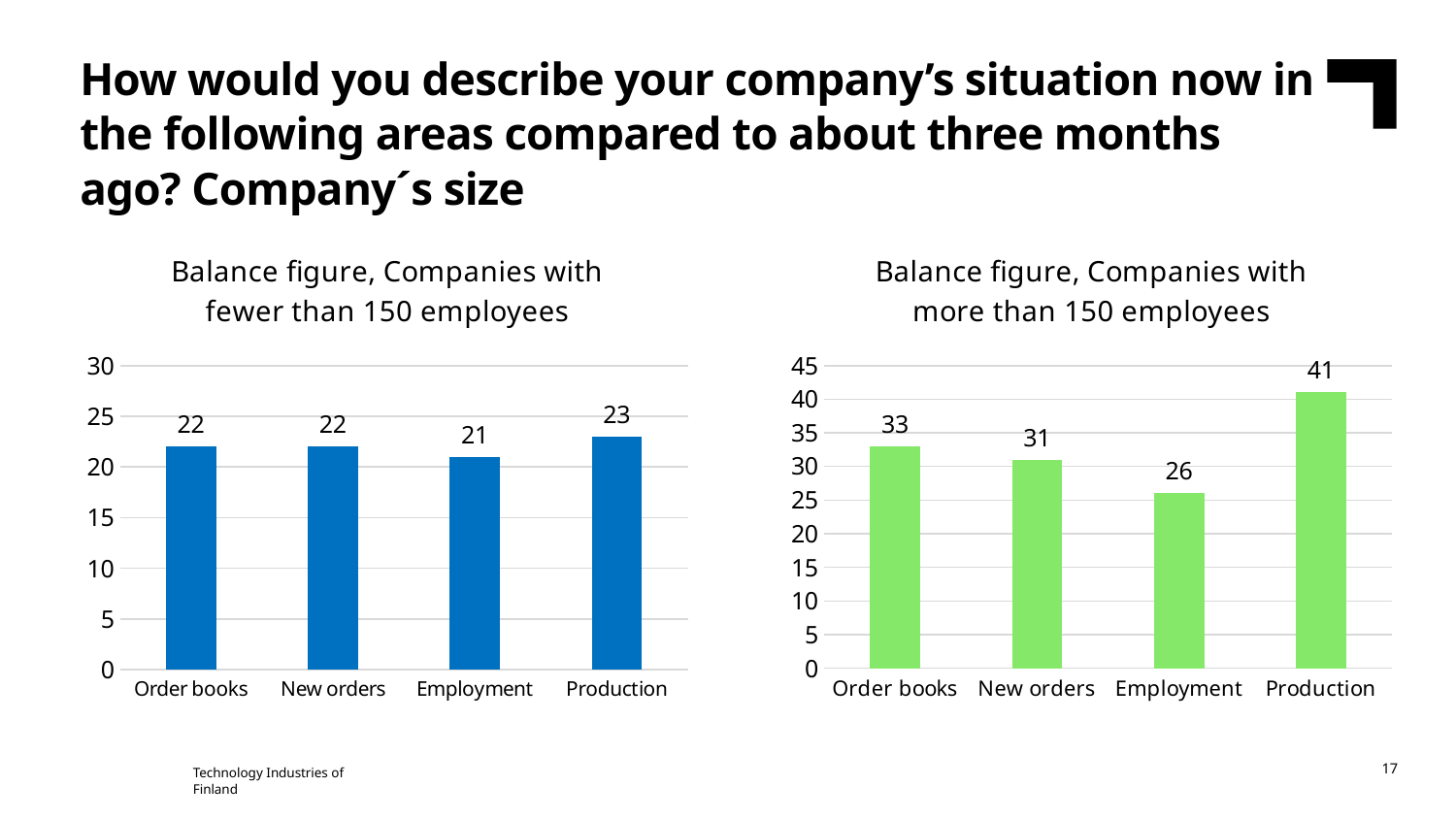
Which is larger: the value for New orders in the chart for companies with fewer than 150 employees, or the value for New orders in the chart for companies with more than 150 employees? Companies with more than 150 employees What kind of chart is 'Balance figure, Companies with more than 150 employees'? Bar chart In the chart 'Balance figure, Companies with fewer than 150 employees', what is the value for Employment? 21 In the chart 'Balance figure, Companies with more than 150 employees', which category has the lowest value? Employment In the chart 'Balance figure, Companies with more than 150 employees', what is the difference between Production and Employment? 15 How many categories are shown in the chart 'Balance figure, Companies with fewer than 150 employees'? 4 In the chart 'Balance figure, Companies with more than 150 employees', what is the value for Order books? 33 In the chart 'Balance figure, Companies with more than 150 employees', which category has the highest value? Production What colour are the bars in the chart 'Balance figure, Companies with fewer than 150 employees'? Blue In the chart 'Balance figure, Companies with fewer than 150 employees', what is the difference between Production and Employment? 2 In the chart 'Balance figure, Companies with more than 150 employees', is the value for Production greater or less than 40? greater In the chart 'Balance figure, Companies with fewer than 150 employees', which category has the lowest value? Employment